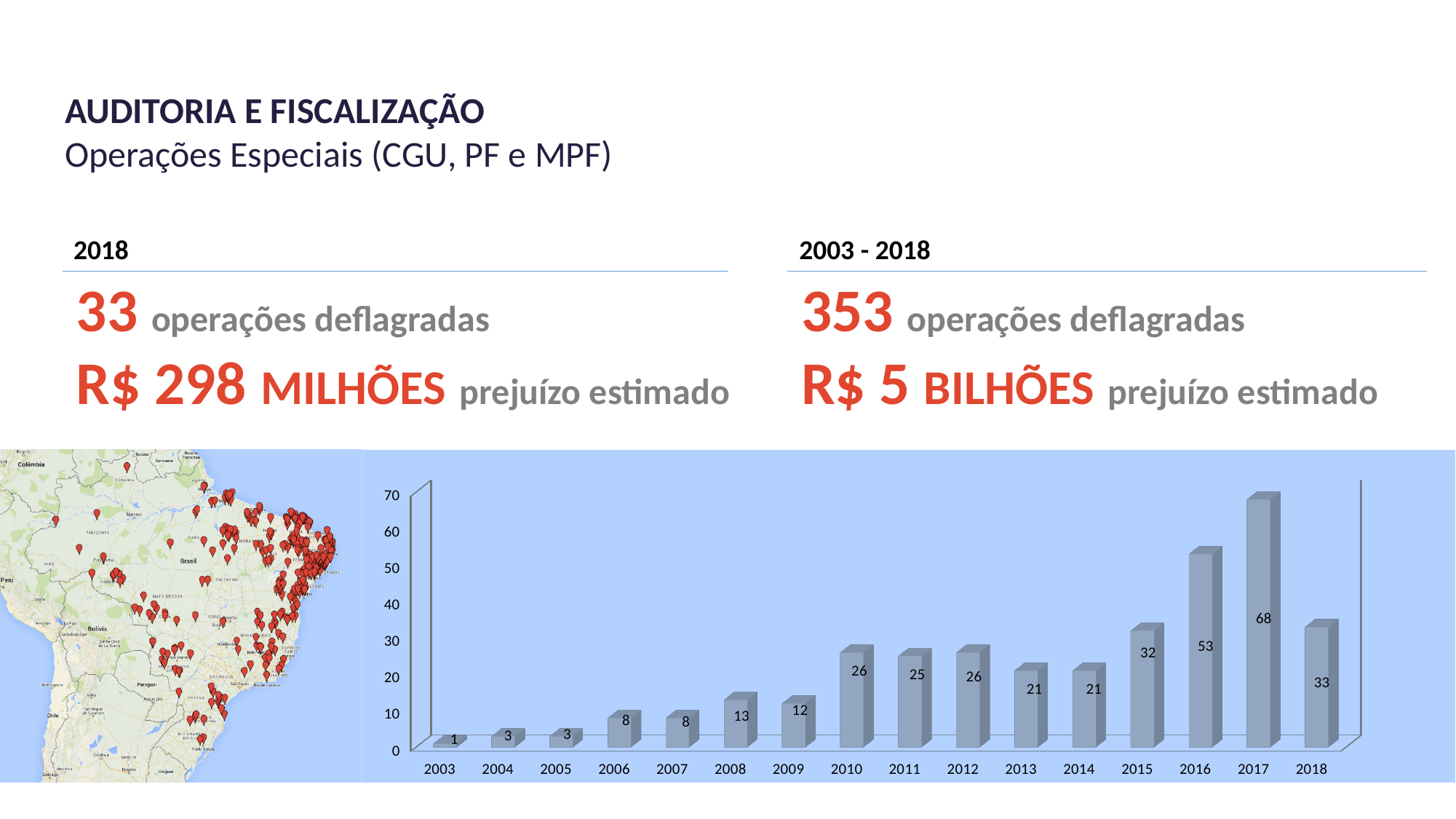
What is the value for 2003 in the bar chart? 1 Which year has the highest value in the bar chart? 2017 What is the value for 2017 in the bar chart? 68 Which is larger, the value for 2016 or the value for 2018? 2016 Is the value for 2016 greater or less than 50? greater What kind of chart is shown on the slide? bar chart Do the values in the bar chart generally rise or fall from 2003 to 2017? rise Which year has the lowest value in the bar chart? 2003 How many years are shown on the x axis of the bar chart? 16 What is the difference between the values for 2018 and 2015? 1 What is the value for 2010 in the bar chart? 26 What is the difference between the values for 2017 and 2016? 15